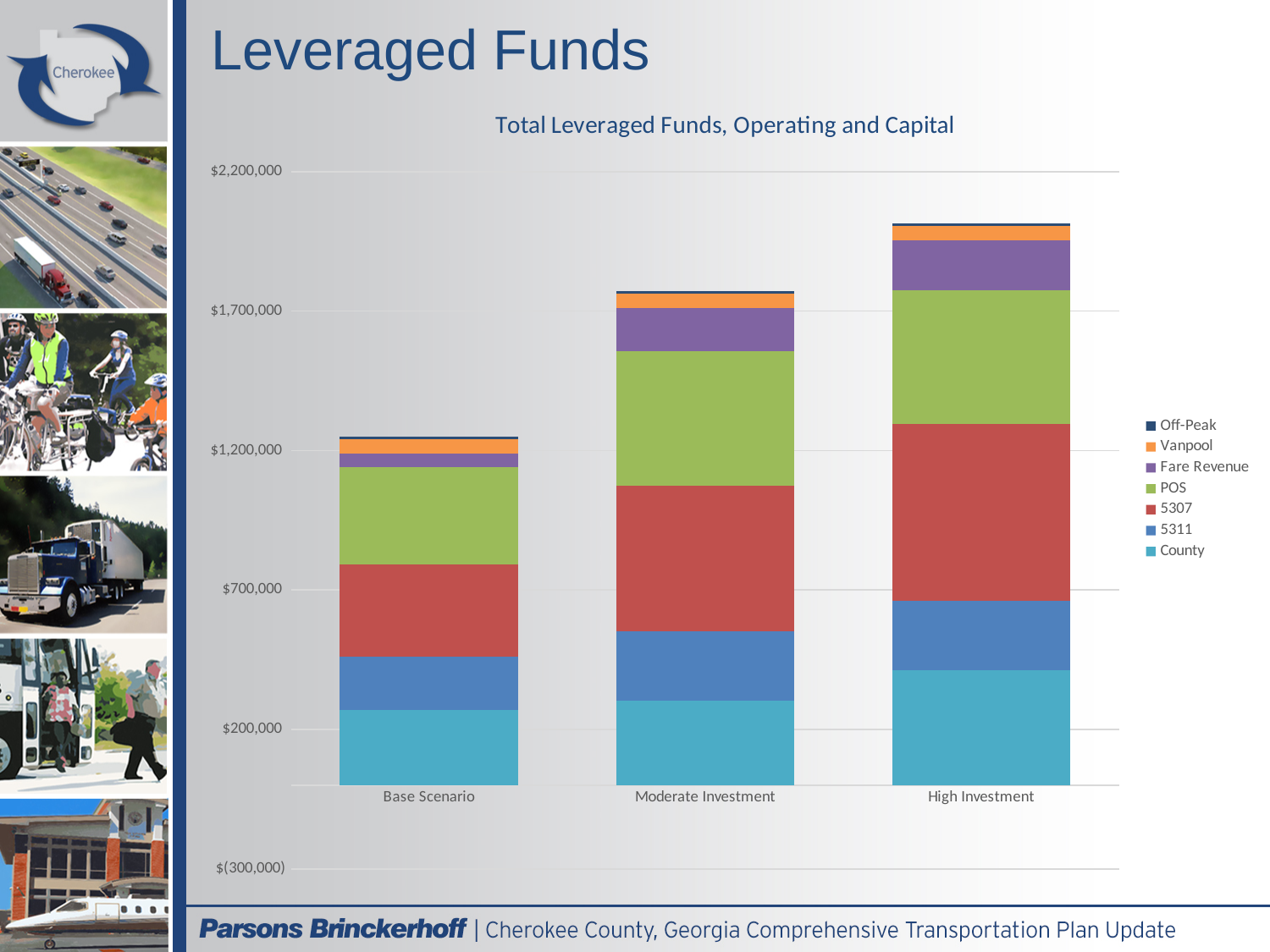
What kind of chart is shown on the slide? Stacked bar chart Do the total leveraged funds rise or fall moving from Base Scenario to High Investment? Rise Which scenario has the highest total leveraged funds? High Investment How many scenarios (categories) are shown on the x axis? 3 What is the title of the chart? Total Leveraged Funds, Operating and Capital Is the total for High Investment greater or less than $1,700,000? greater Which series is shown in the bottom (light blue) segment of each bar? County Is the total for Base Scenario greater or less than $700,000? greater How many series does the legend list? 7 Which scenario has the lowest total leveraged funds? Base Scenario Is the total for High Investment greater or less than $2,200,000? less Which scenario has the larger POS segment, Base Scenario or Moderate Investment? Moderate Investment